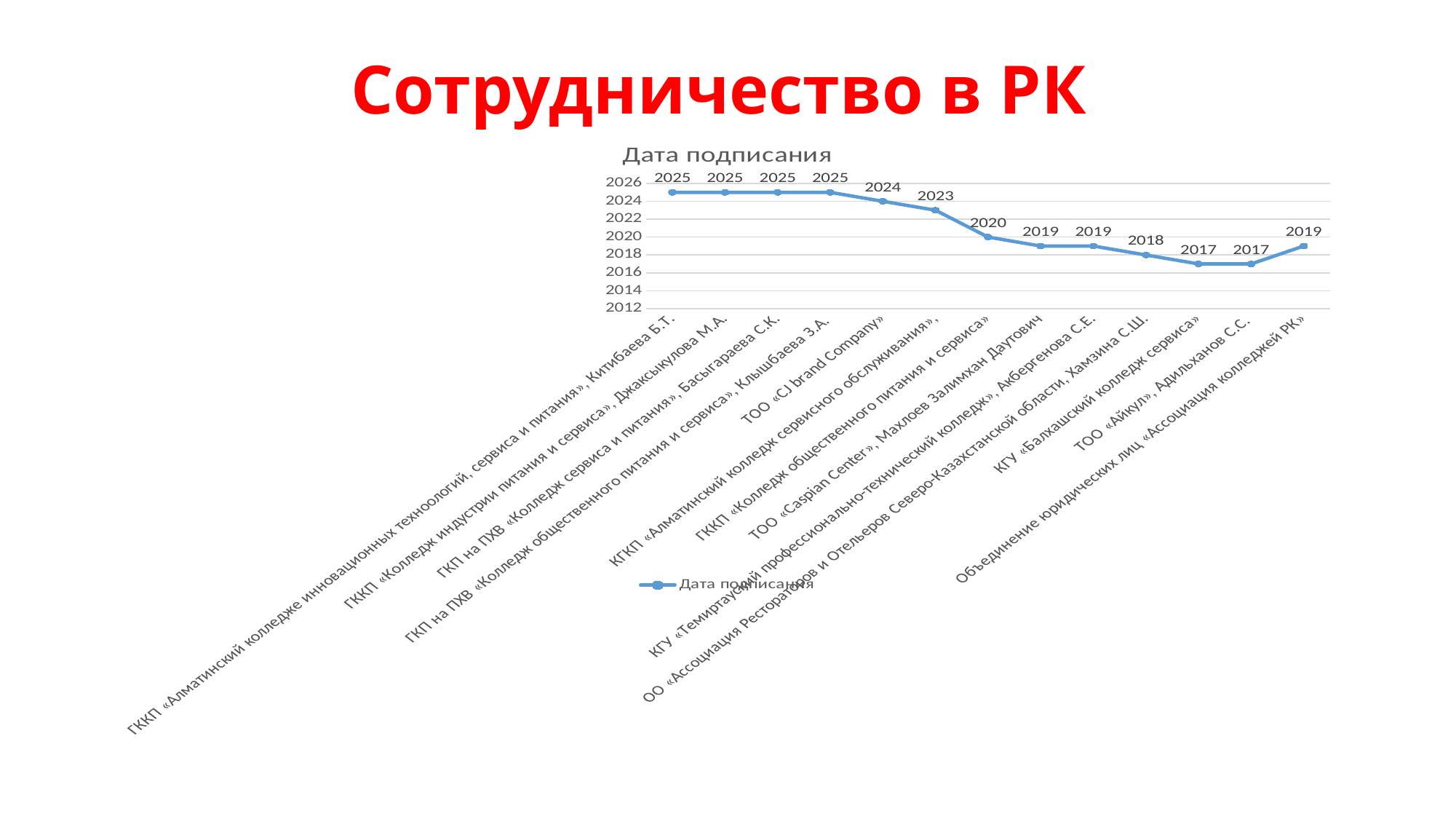
What is the title of the chart? Дата подписания How many data points are plotted on the chart? 13 How many series does the legend list? 1 What is the value for Объединение юридических лиц «Ассоциация колледжей РК»? 2019 What kind of chart is shown on the slide? line chart What is the value for КГКП «Алматинский колледж сервисного обслуживания»? 2023 What is the value for ТОО «CJ brand Company»? 2024 What is the lowest value plotted on the chart? 2017 What is the highest value plotted on the chart? 2025 Which is larger: the value for ГККП «Колледж общественного питания и сервиса» or the value for ТОО «Caspian Center», Махлоев Залимхан Даутович? ГККП «Колледж общественного питания и сервиса» What is the difference between the value for ТОО «CJ brand Company» and the value for ТОО «Айкул», Адильханов С.С.? 7 What is the value for КГУ «Балхашский колледж сервиса»? 2017